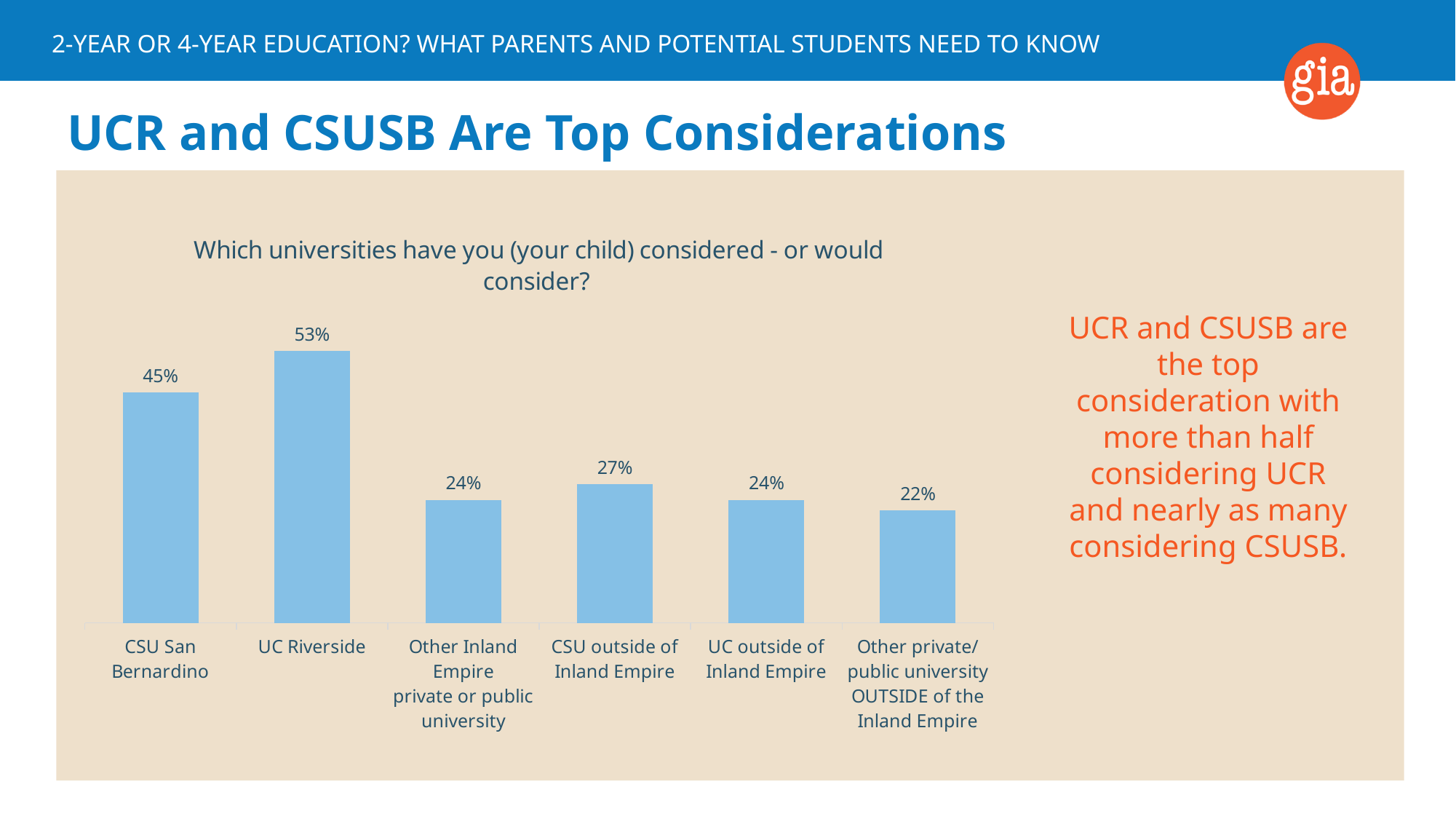
Which category has the lowest percentage? Other private/public university OUTSIDE of the Inland Empire How many categories are shown in the chart? 6 Which is larger, the value for CSU San Bernardino or the value for CSU outside of Inland Empire? CSU San Bernardino What is the value shown for CSU San Bernardino? 45% What percentage is shown for CSU outside of Inland Empire? 27% What percentage of respondents considered UC Riverside? 53% What is the value for Other private/public university OUTSIDE of the Inland Empire? 22% What is the title of the chart? Which universities have you (your child) considered - or would consider? Which university category has the highest percentage? UC Riverside What is the difference between CSU outside of Inland Empire and UC outside of Inland Empire? 3% What is the difference between the percentages for UC Riverside and CSU San Bernardino? 8% What type of chart is shown on the slide? Bar chart